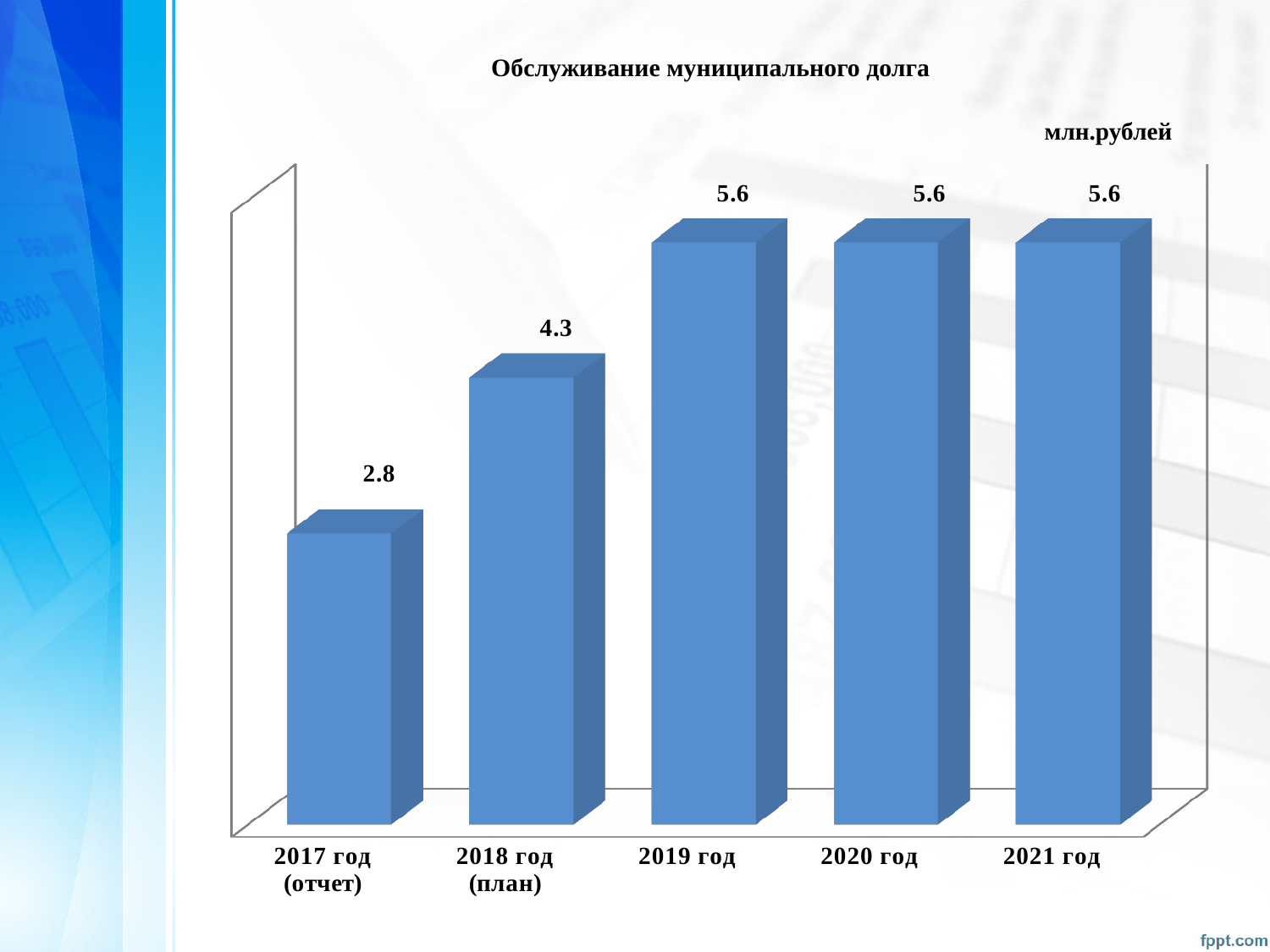
Do the values rise or fall from 2017 год (отчет) to 2019 год? rise What is the difference between the values for 2018 год (план) and 2017 год (отчет)? 1.5 What kind of chart is this? bar chart What is the value for 2017 год (отчет)? 2.8 What is the difference between the values for 2019 год and 2018 год (план)? 1.3 How many categories are shown on the x axis? 5 Which is larger, the value for 2018 год (план) or the value for 2020 год? 2020 год Which category has the lowest value? 2017 год (отчет) What is the title of the chart? Обслуживание муниципального долга What is the value for 2019 год? 5.6 What is the value for 2018 год (план)? 4.3 What unit is shown for the values on the chart? млн.рублей